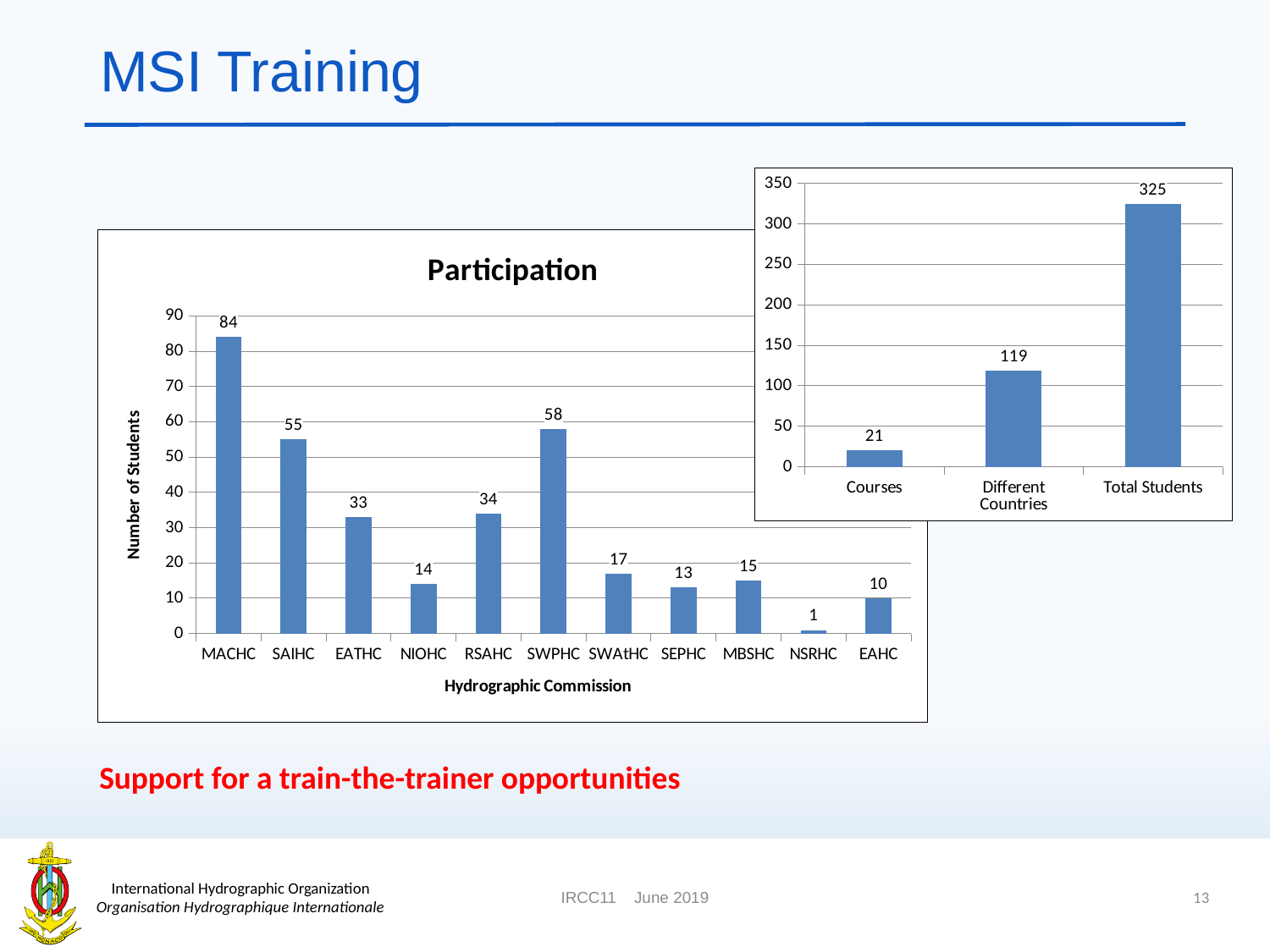
In the Participation chart, what is the difference in number of students between SWPHC and SAIHC? 3 In the Participation chart, what is the number of students for SWAtHC? 17 What kind of chart is the Participation chart? Bar chart In the chart at the top right of the slide, what is the value for Courses? 21 In the chart at the top right of the slide, what is the value for Different Countries? 119 In the Participation chart, how many hydrographic commissions are shown on the x axis? 11 In the Participation chart, which has more students, EATHC or RSAHC? RSAHC In the Participation chart, how many students are shown for MACHC? 84 What is the label of the y axis in the Participation chart? Number of Students In the chart at the top right of the slide, what is the difference between Total Students and Different Countries? 206 In the Participation chart, which hydrographic commission has the lowest number of students? NSRHC In the Participation chart, which hydrographic commission has the highest number of students? MACHC